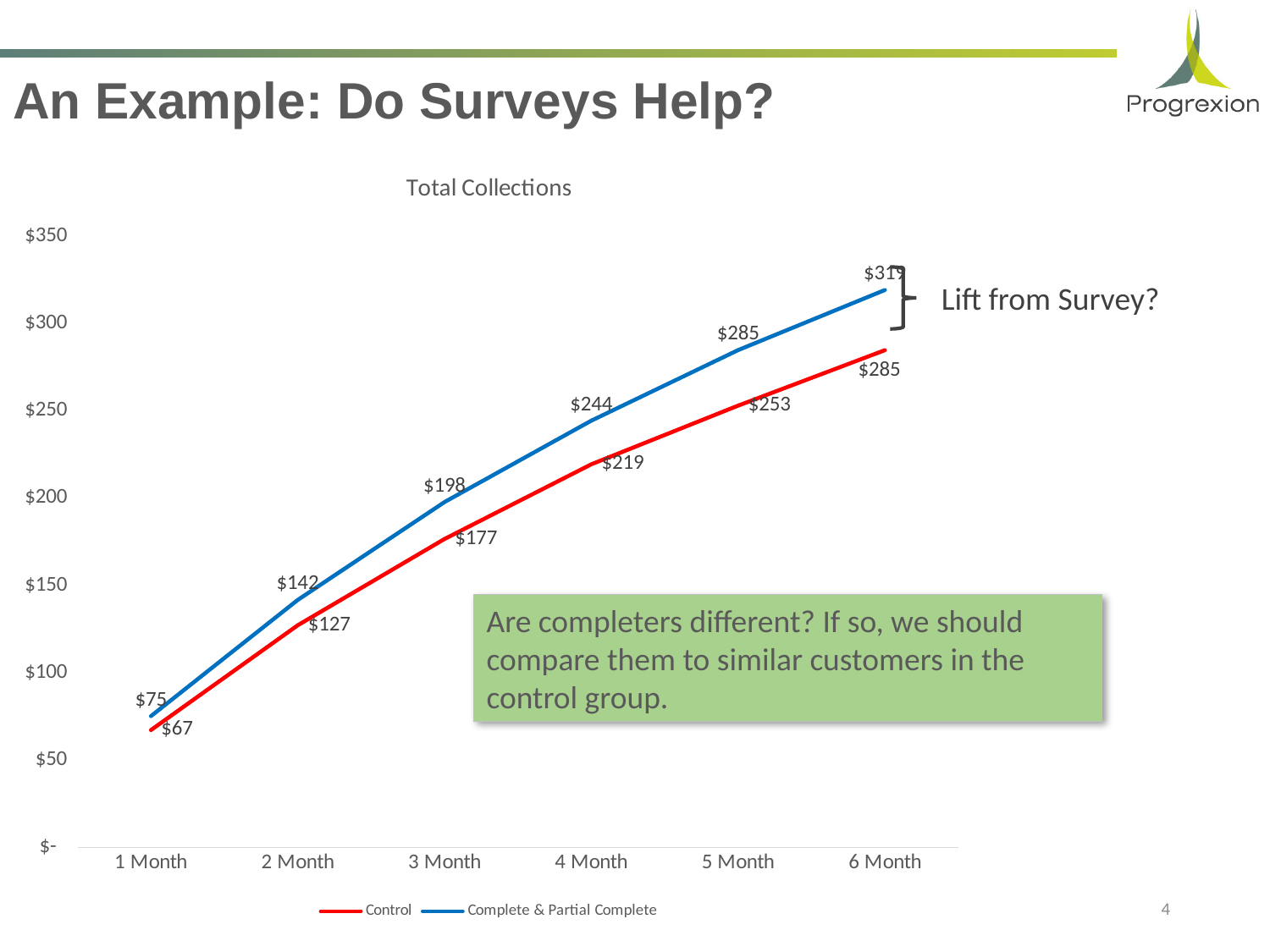
What is the Complete & Partial Complete value at 4 Month? $244 What is the difference between the Complete & Partial Complete and Control values at 2 Month? $15 What kind of chart is shown on the slide? line chart What is the Control value at 3 Month? $177 Do the Control values rise or fall from 1 Month to 6 Month? rise What is the Control value at 6 Month? $285 At 5 Month, which series has the higher value, Control or Complete & Partial Complete? Complete & Partial Complete Is the Complete & Partial Complete value at 6 Month greater or less than $300? greater What is the title of the chart? Total Collections How many categories are shown on the x axis? 6 What is the Complete & Partial Complete value at 1 Month? $75 How many series does the legend list? 2